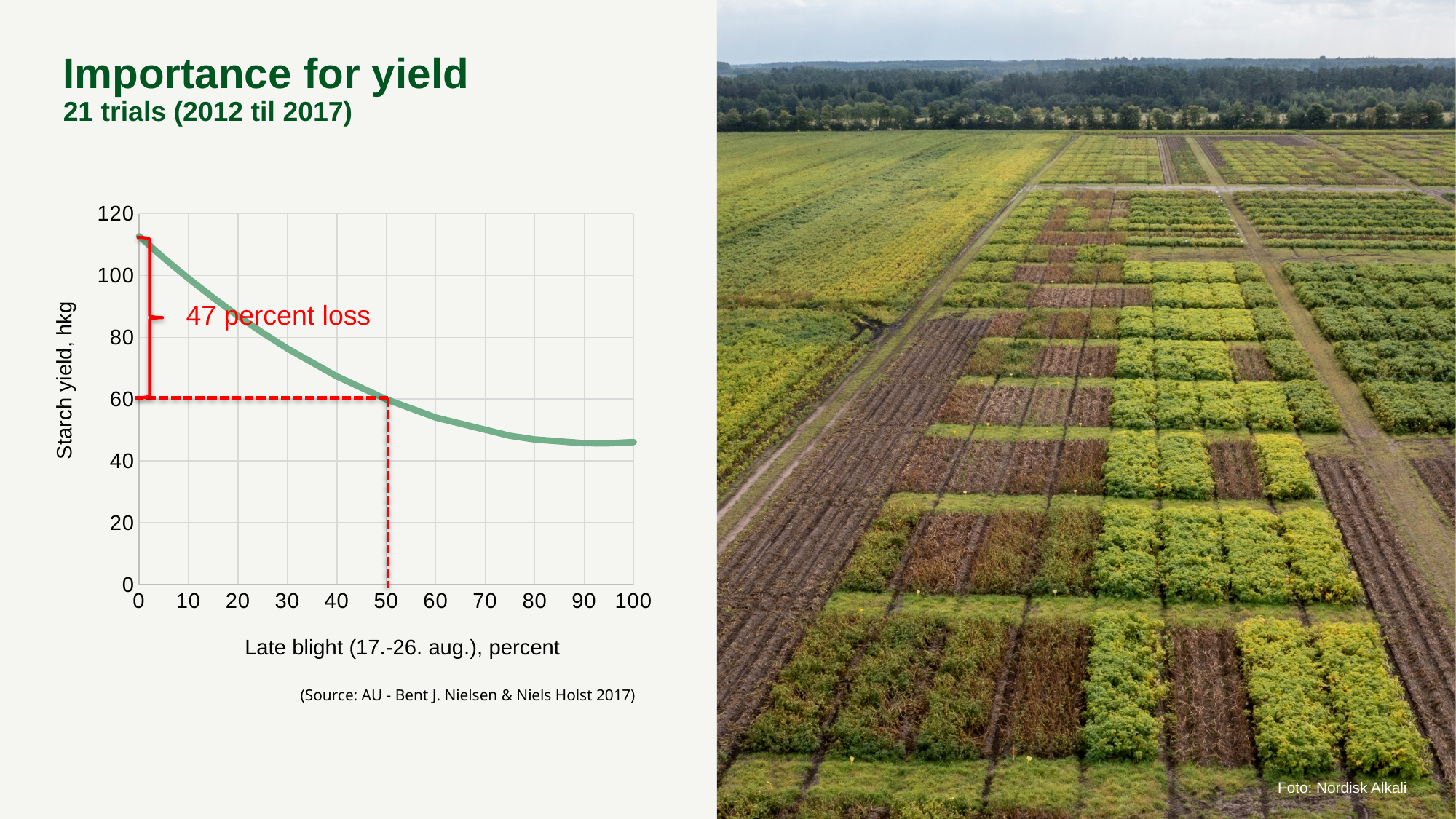
Is the starch yield at 20 percent late blight greater or less than 80? greater Is the starch yield at 80 percent late blight greater or less than 60? less What kind of chart is shown on the slide? line chart What is the highest value shown on the y axis? 120 What is the label of the y axis? Starch yield, hkg What is the highest value shown on the x axis? 100 What starch yield does the dashed red line mark at 50 percent late blight? 60 Is the starch yield at 0 percent late blight greater or less than 100? greater Does starch yield rise or fall as late blight percent increases along the x axis? fall Which has the higher starch yield: 10 percent late blight or 70 percent late blight? 10 percent late blight What percent loss does the red annotation on the chart state? 47 percent loss